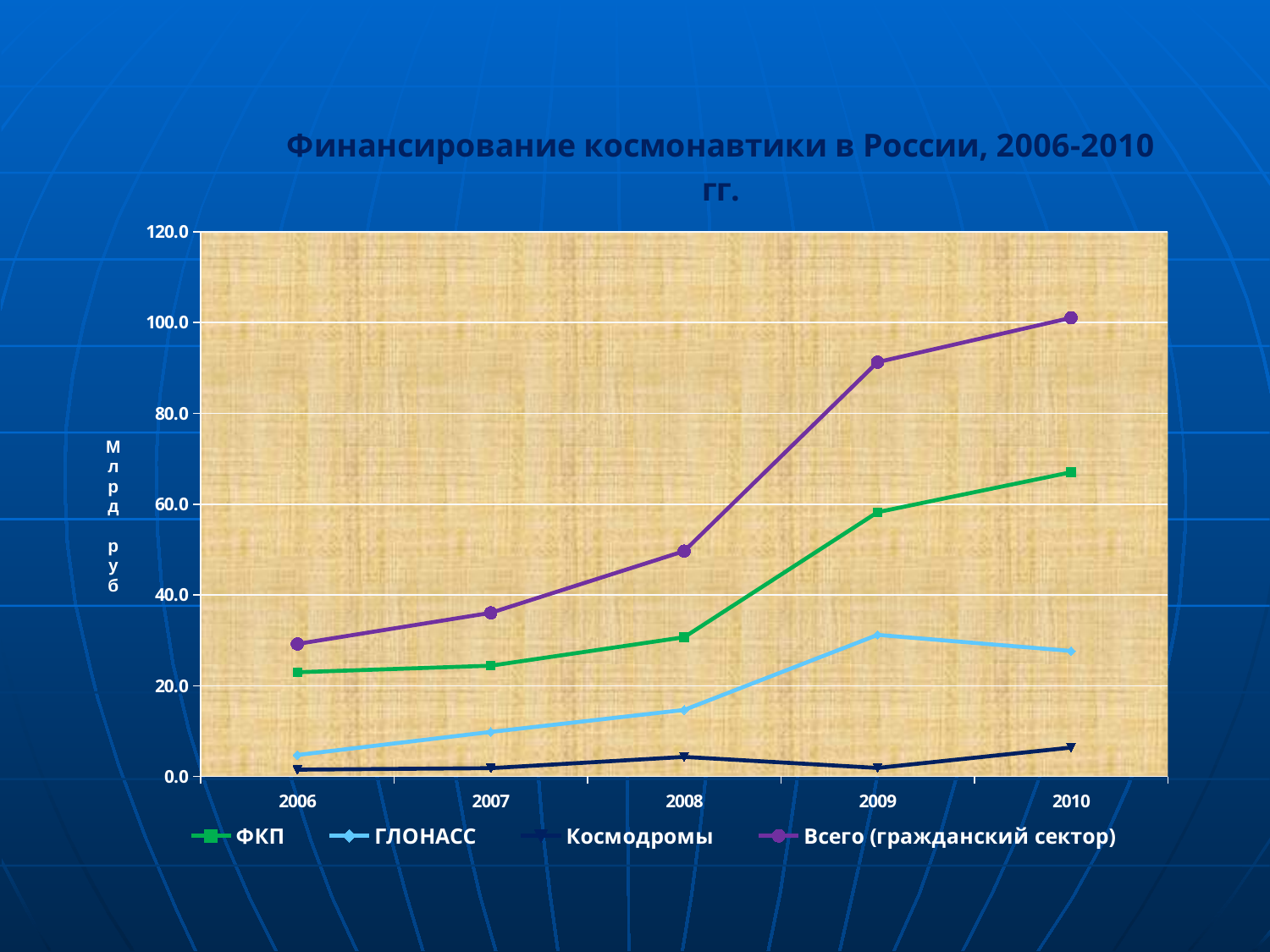
Is the value for ФКП in 2008 greater or less than 40? less How many years are plotted along the x axis? 5 Which series has the lowest values across all years? Космодромы What is the title of the chart? Финансирование космонавтики в России, 2006-2010 гг. Which is larger in 2010, ФКП or ГЛОНАСС? ФКП In which year does the ГЛОНАСС series reach its highest value? 2009 Which series has the highest value in 2010? Всего (гражданский сектор) How many series does the legend list? 4 Does the Всего (гражданский сектор) series rise or fall from 2006 to 2010? rise In which year is the ФКП series at its lowest? 2006 Is the value for Всего (гражданский сектор) in 2009 greater or less than 80? greater What kind of chart is shown on the slide? line chart